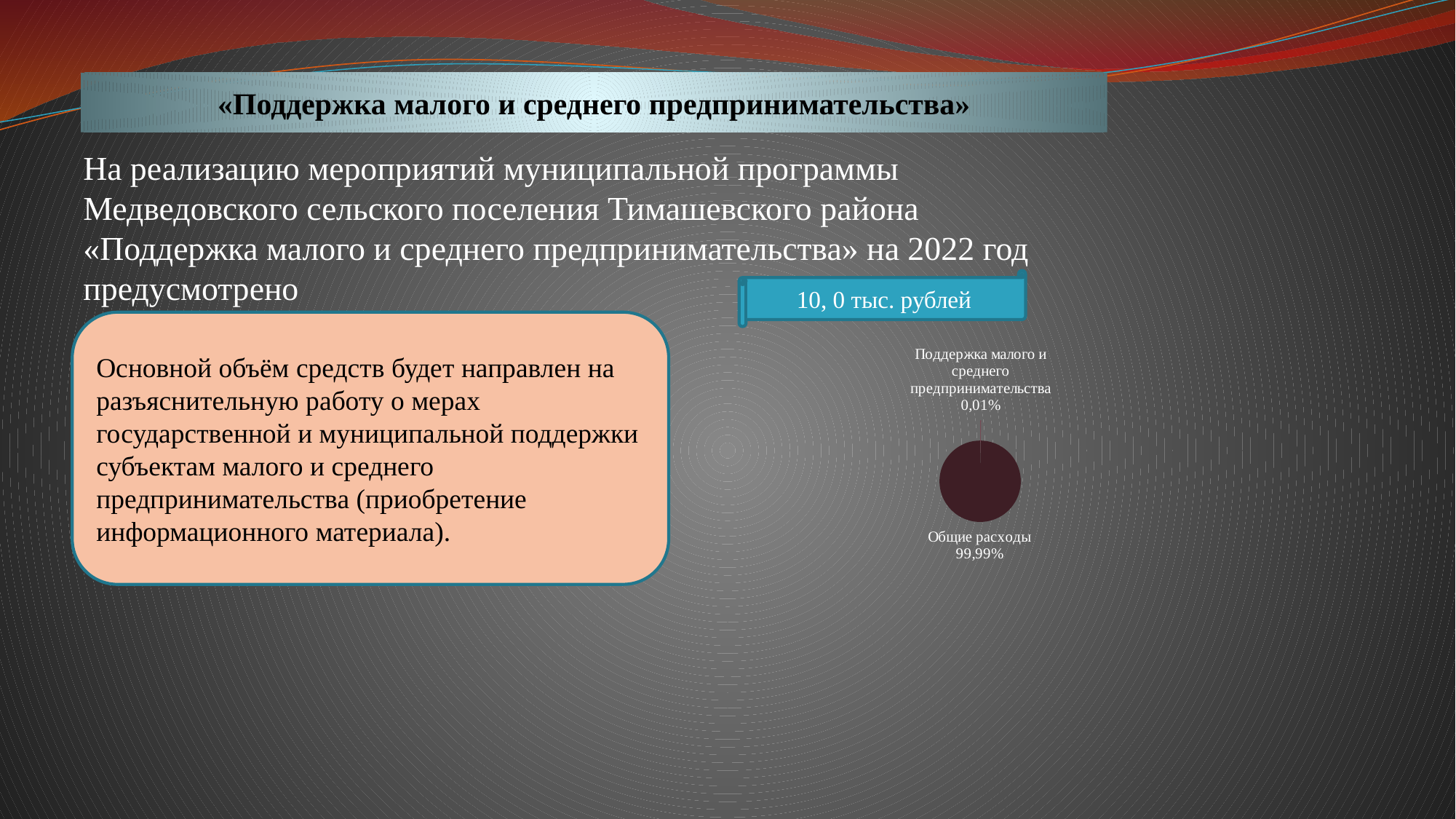
What kind of chart is shown on the slide? pie chart What share of the pie does "Общие расходы" represent? 99,99% Which slice of the pie chart is the largest? Общие расходы What is the difference in percentage points between "Общие расходы" and "Поддержка малого и среднего предпринимательства"? 99,98 What is the total of the two percentages shown on the pie chart? 100% How many slices does the pie chart have? 2 What colour is the pie chart's dominant slice? dark maroon What share of the pie does "Поддержка малого и среднего предпринимательства" represent? 0,01% Which is larger: the share for "Общие расходы" or the share for "Поддержка малого и среднего предпринимательства"? Общие расходы Which slice of the pie chart is the smallest? Поддержка малого и среднего предпринимательства